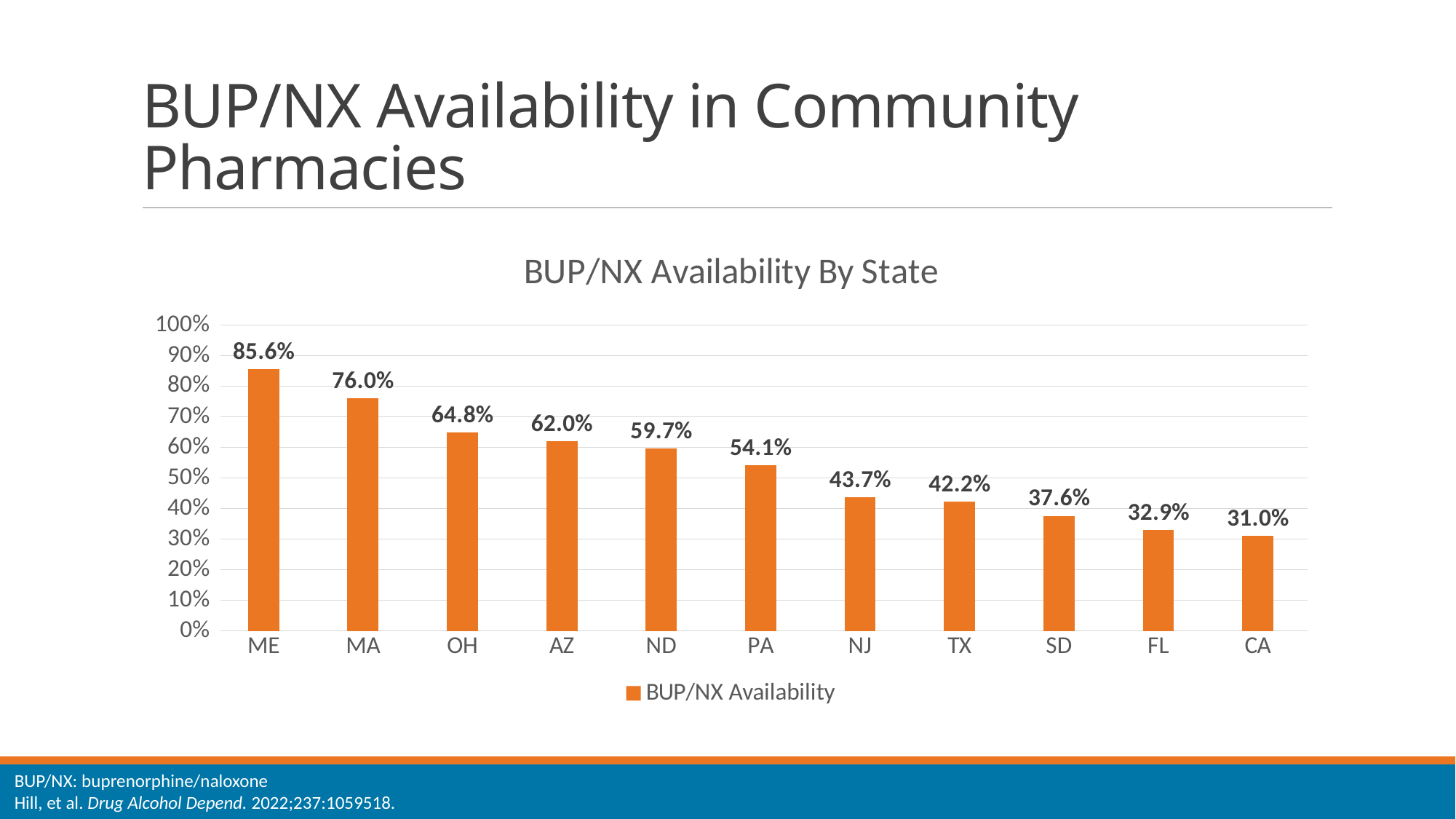
What is the BUP/NX availability for CA? 31.0% What is the difference in BUP/NX availability between ME and MA? 9.6% Which state has the lowest BUP/NX availability? CA Which state has higher BUP/NX availability, ND or SD? ND How many series does the legend list? 1 What is the difference in BUP/NX availability between OH and CA? 33.8% What is the BUP/NX availability for ME? 85.6% What is the BUP/NX availability for PA? 54.1% What is the title of the chart? BUP/NX Availability By State How many states are shown on the chart? 11 Which state has the highest BUP/NX availability? ME What kind of chart is shown on the slide? Bar chart